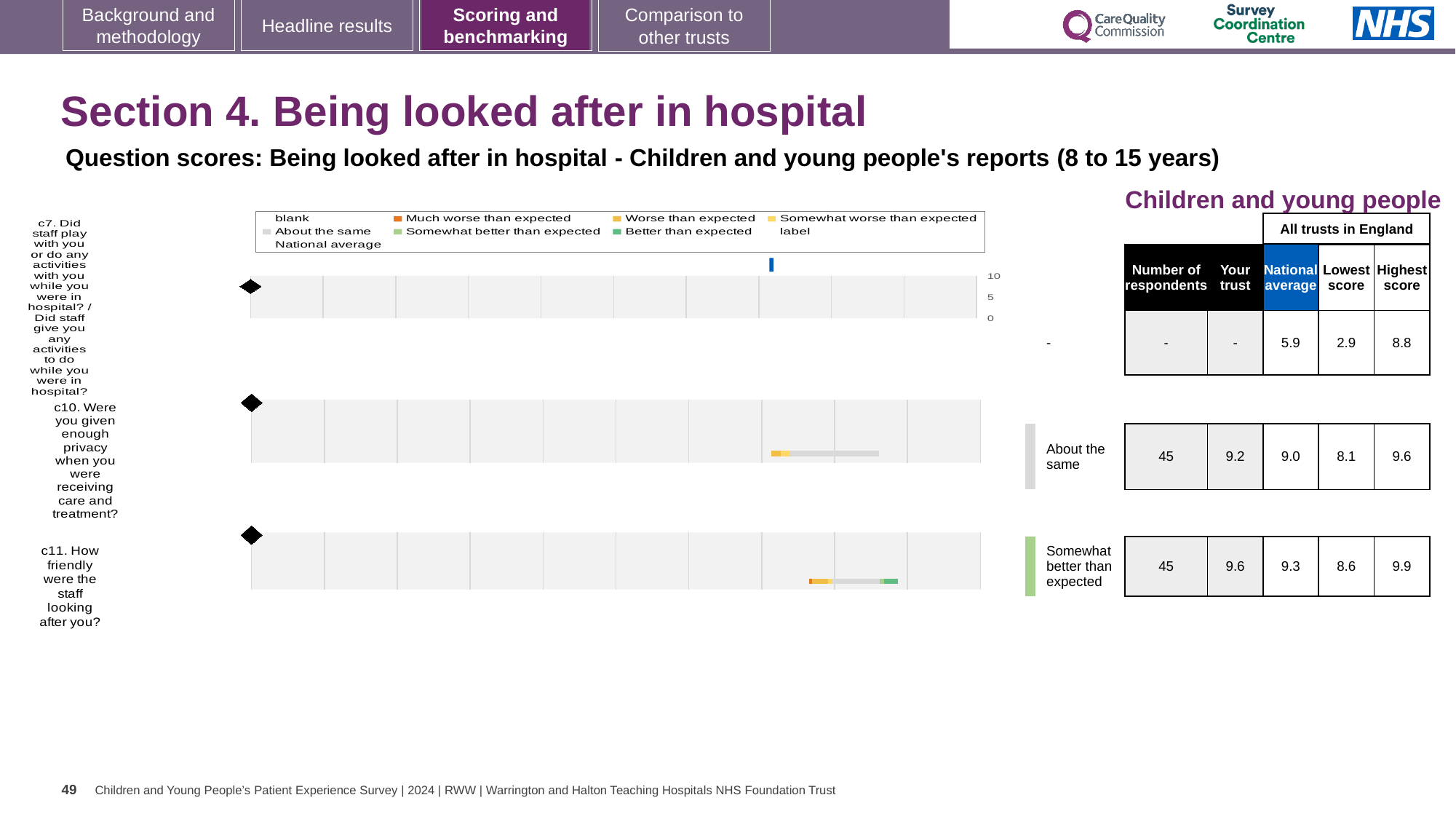
What is the subtitle of the chart on this slide? Question scores: Being looked after in hospital - Children and young people's reports (8 to 15 years) What is the 'Your trust' score for question c11 (How friendly were the staff looking after you?)? 9.6 What is the difference between the 'Your trust' score and the national average for question c11? 0.3 How many respondents answered question c11? 45 What is the highest score across all trusts in England for question c11? 9.9 What is the lowest score across all trusts in England for question c10? 8.1 What kind of chart is used to show the question scores on this slide? bar chart What is the national average score for question c7 (Did staff play with you or do any activities with you while you were in hospital?)? 5.9 What is the 'Your trust' score for question c10 (Were you given enough privacy when you were receiving care and treatment?)? 9.2 Which question has the higher 'Your trust' score, c10 or c11? c11 How many survey questions are plotted in the chart? 3 What benchmark category is shown for question c11? Somewhat better than expected